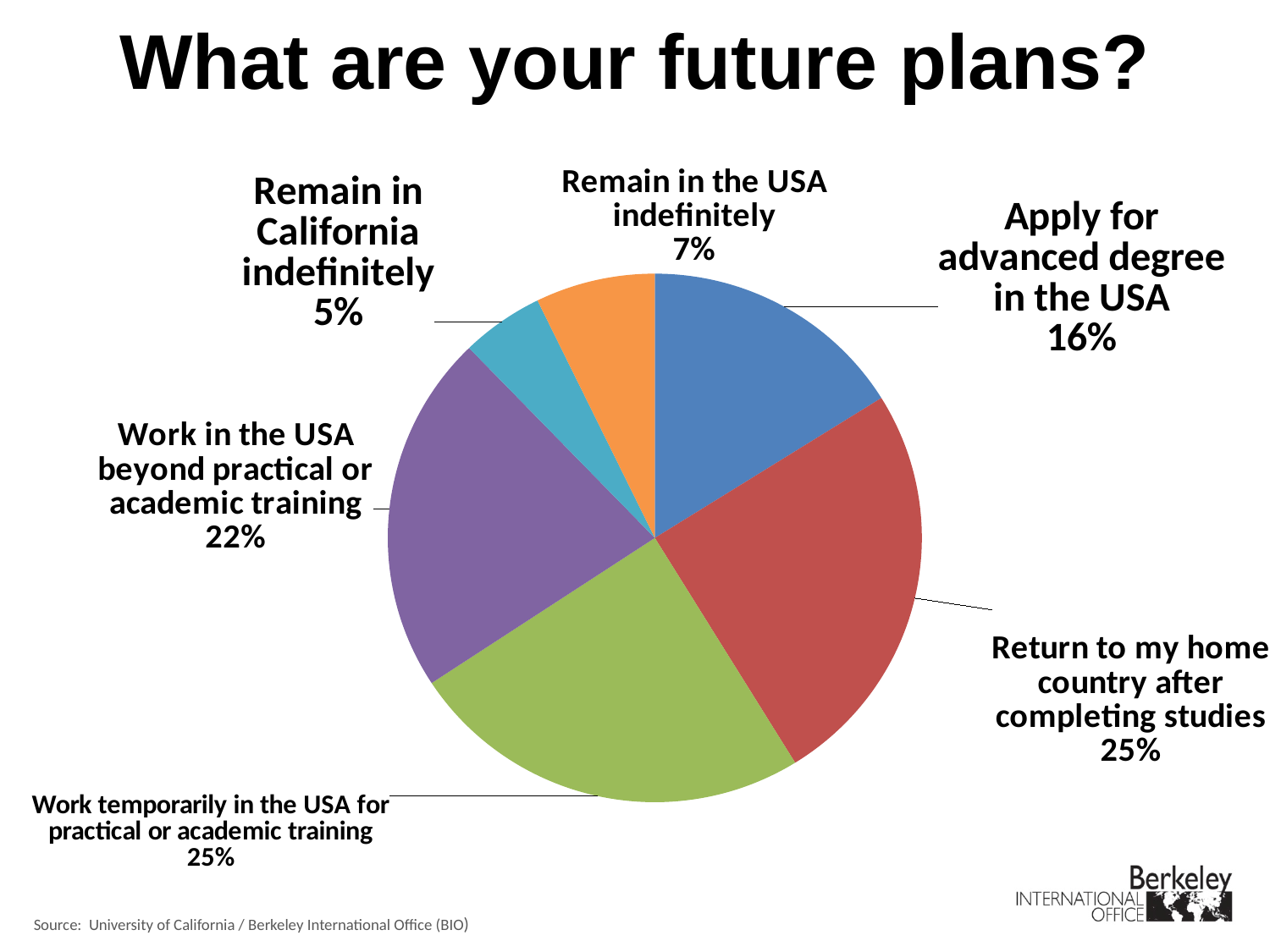
What is the difference in percentage points between 'Return to my home country after completing studies' and 'Apply for advanced degree in the USA'? 9 percentage points What share of respondents plan to work in the USA beyond practical or academic training? 22% Which future plan has the smallest share of respondents? Remain in California indefinitely What percentage of respondents plan to remain in the USA indefinitely? 7% What is the title of the slide? What are your future plans? What percentage of respondents plan to return to their home country after completing studies? 25% What percentage of respondents plan to apply for an advanced degree in the USA? 16% What type of chart is shown on the slide? Pie chart What is the share of the smallest slice in the pie chart? 5% What is the difference in percentage points between 'Work in the USA beyond practical or academic training' and 'Remain in California indefinitely'? 17 percentage points Which is larger: the share for 'Work in the USA beyond practical or academic training' or the share for 'Apply for advanced degree in the USA'? Work in the USA beyond practical or academic training How many future plan categories are shown in the pie chart? 6